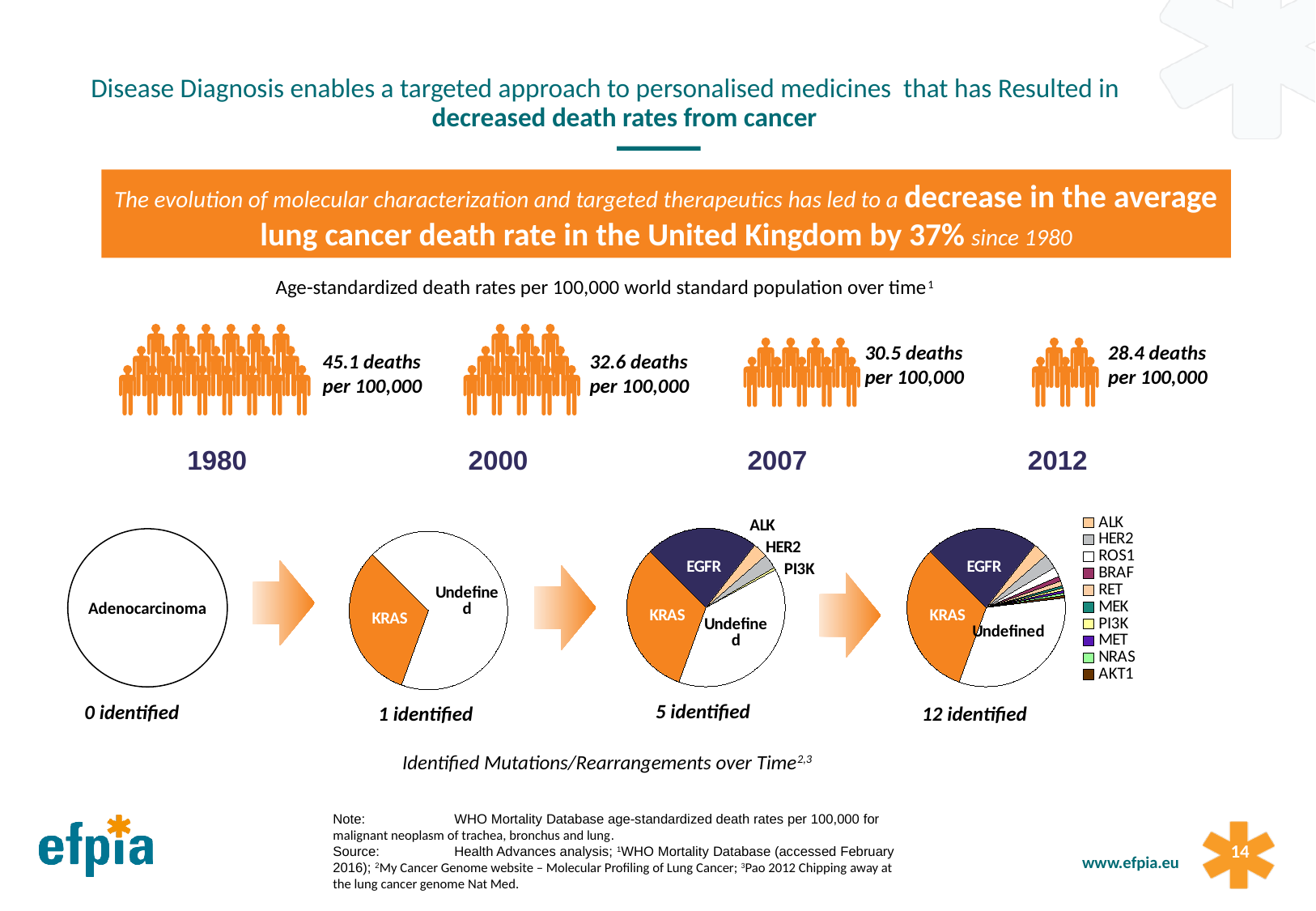
In the age-standardized death rate infographic, what is the difference between the 1980 and 2012 death rates per 100,000? 16.7 How many pie charts are shown in the 'Identified Mutations/Rearrangements over Time' row? 4 How many mutations/rearrangements are identified in the 2007 pie chart? 5 identified In the age-standardized death rate infographic, which year has the lowest death rate? 2012 In the 2012 pie chart, how many entries does the legend list? 10 In the age-standardized death rate infographic, do the death rates rise or fall from 1980 to 2012? Fall In the 2000 pie chart (1 identified), which slice is larger: KRAS or Undefined? Undefined How many mutations/rearrangements are identified in the 2012 pie chart? 12 identified What kind of charts are used to show the identified mutations/rearrangements over time? Pie charts In the age-standardized death rate infographic, what is the death rate shown for 1980? 45.1 deaths per 100,000 What is the only category shown in the 1980 pie chart (0 identified)? Adenocarcinoma In the 2007 pie chart (5 identified), which labelled slice is the largest? Undefined